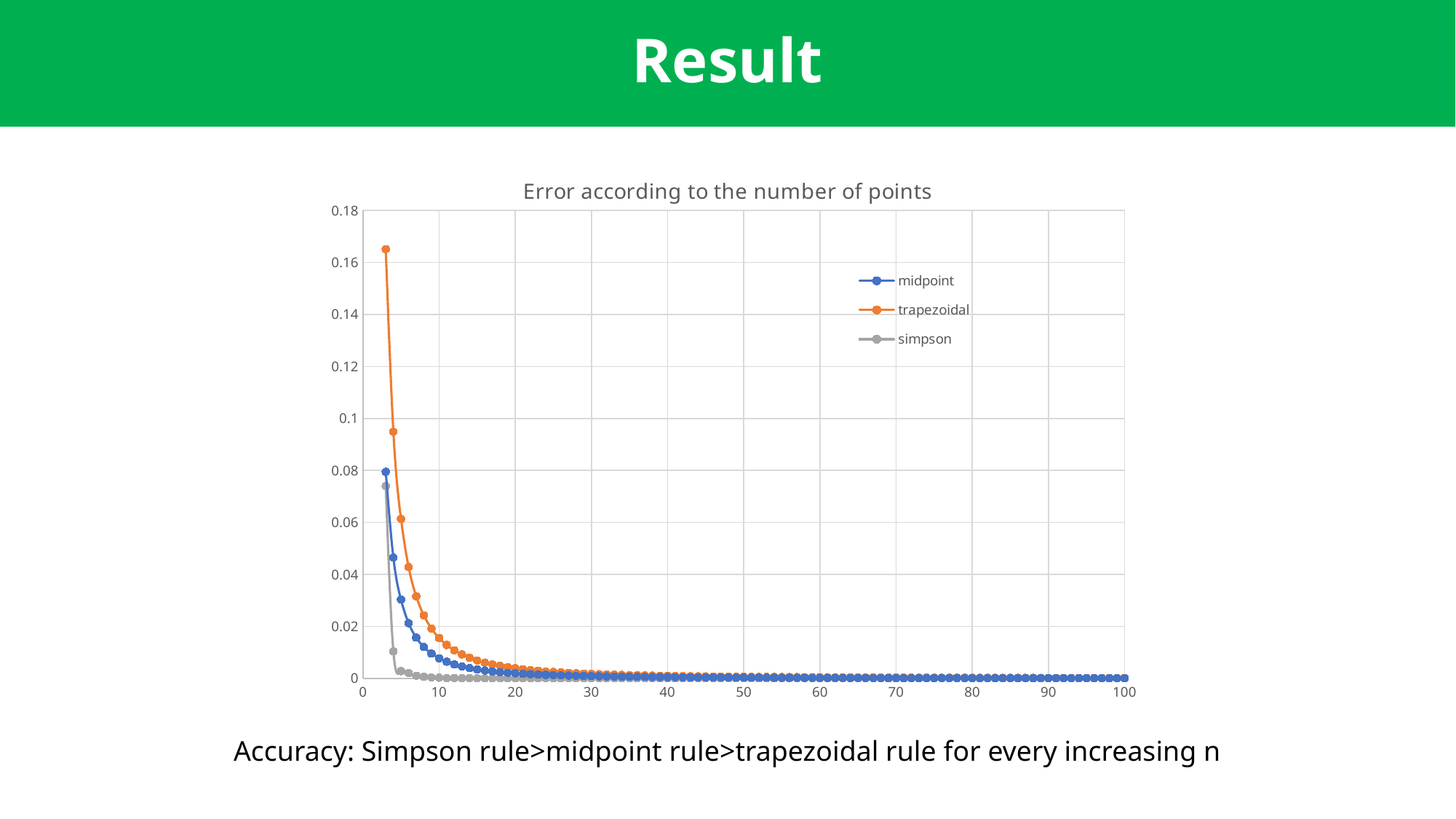
Do the error values rise or fall as the number of points increases along the x axis? fall Is the highest value of the midpoint series greater or less than 0.1? less How many series does the legend list? 3 What is the title of the chart? Error according to the number of points Is the highest value of the trapezoidal series greater or less than 0.14? greater Is the highest value of the simpson series greater or less than 0.08? less What kind of chart is shown on the slide? line chart Which series has the lowest error at the smallest number of points? simpson At the smallest number of points, which series has the larger error: midpoint or trapezoidal? trapezoidal At around 10 points, which series has the larger error: midpoint or simpson? midpoint Which series is drawn in orange? trapezoidal Which series has the highest error at the smallest number of points? trapezoidal